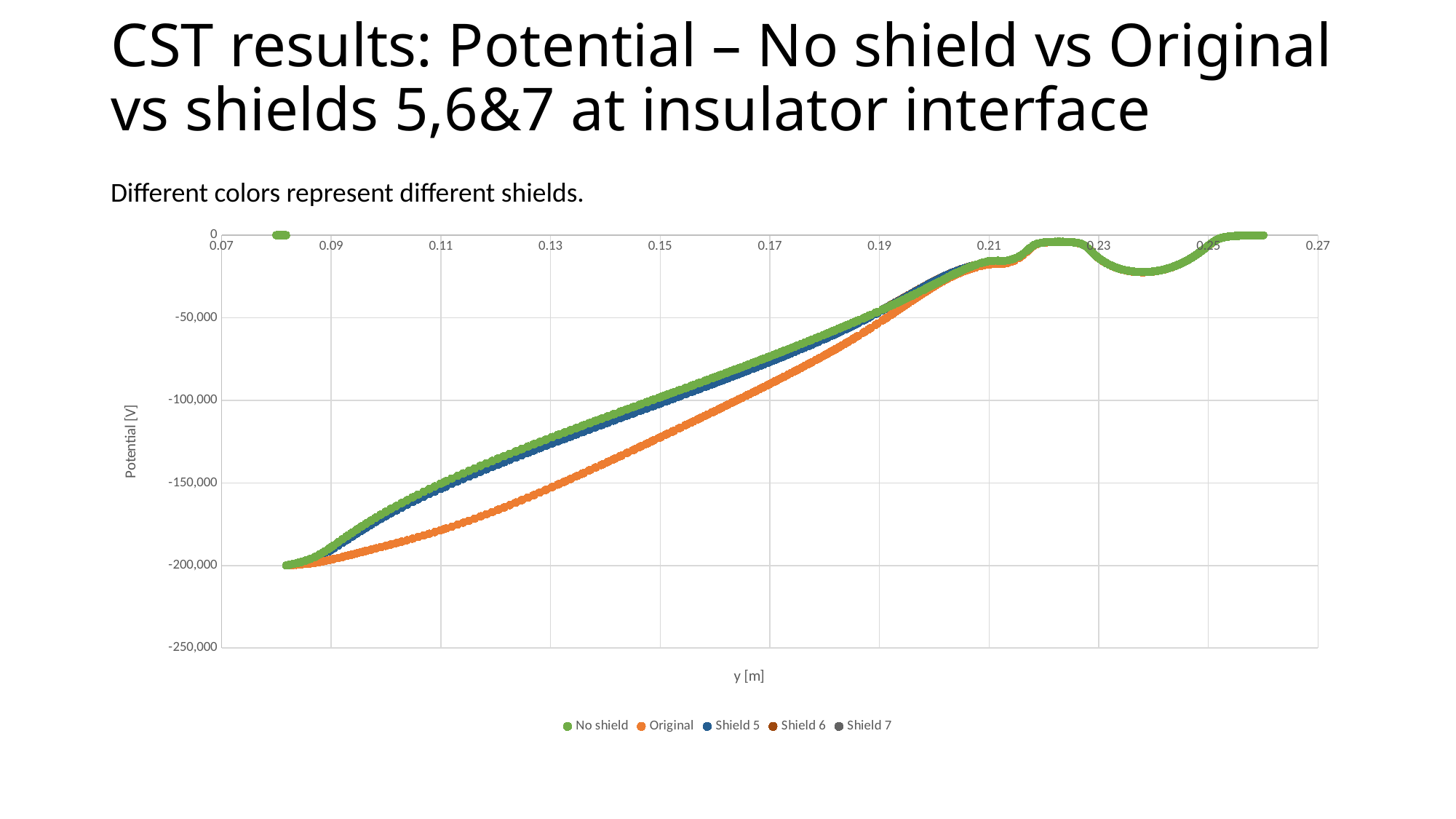
Is the value of the No shield series at y = 0.19 m greater or less than -100,000? greater Is the value of the Original series at y = 0.17 m greater or less than -50,000? less At y = 0.15 m, which series has the lower potential, Original or Shield 5? Original Is the value of the Original series at y = 0.11 m greater or less than -150,000? less Do the potential values rise or fall as y [m] increases from 0.09 to 0.21? rise Which series is shown in orange in the legend? Original What is the label of the vertical axis? Potential [V] What kind of chart is shown on the slide? scatter (line) chart How many series does the legend list? 5 At y = 0.13 m, which series has the higher potential, No shield or Original? No shield What is the lowest potential value reached by the curves, as read from the y axis? -200,000